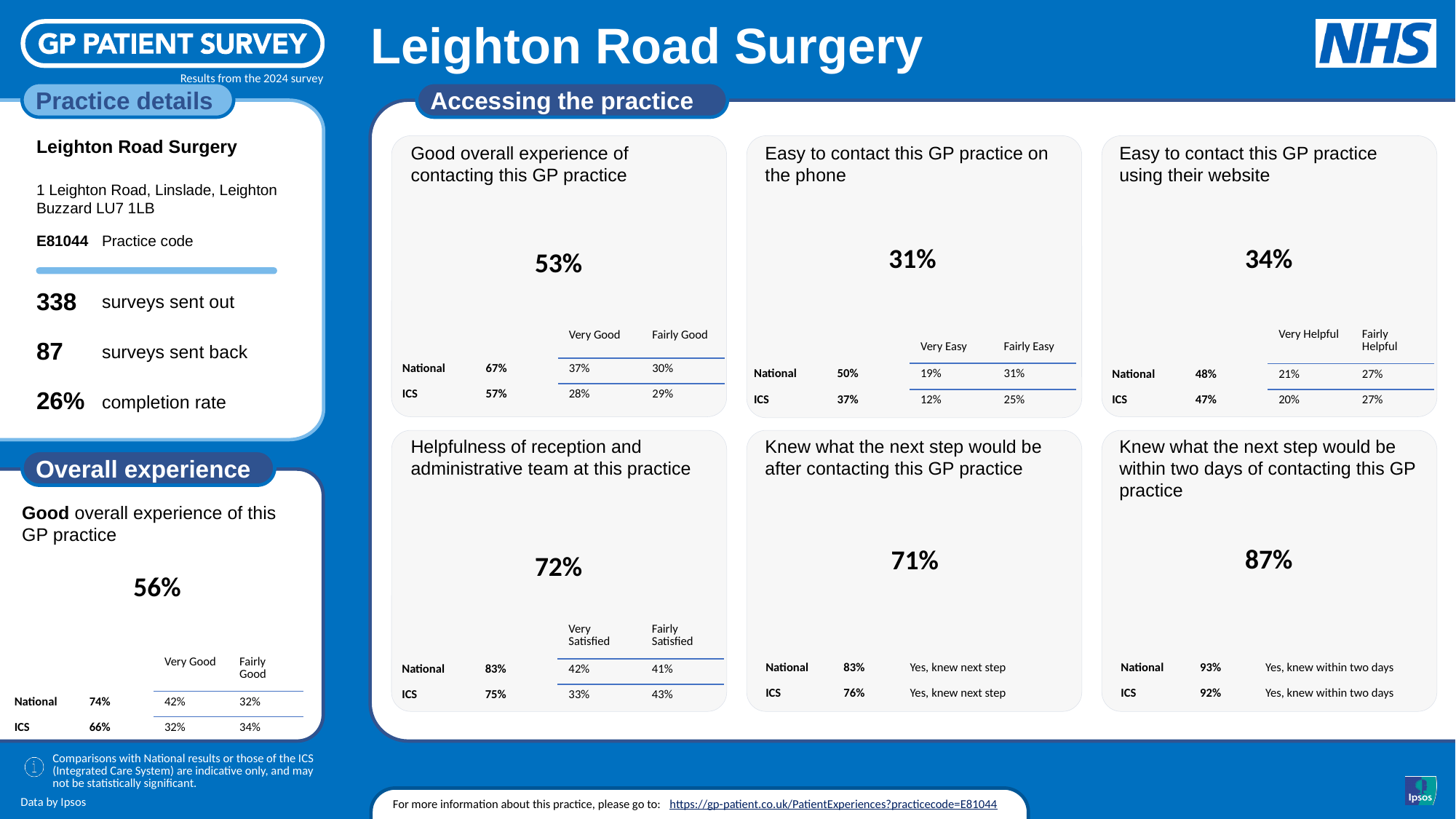
Among the six panels under 'Accessing the practice', which has the highest practice headline percentage? Knew what the next step would be within two days of contacting this GP practice In the 'Helpfulness of reception and administrative team at this practice' panel, what is the ICS value for Very Satisfied? 33% In the 'Easy to contact this GP practice on the phone' panel, what is the difference between the National value and the ICS value? 13% In the 'Easy to contact this GP practice using their website' panel, what is the National value? 48% In the 'Good overall experience of this GP practice' panel under Overall experience, what is the National value for Fairly Good? 32% In the 'Good overall experience of contacting this GP practice' panel, what is the difference between the National value and the practice's headline percentage? 14% In the 'Knew what the next step would be within two days of contacting this GP practice' panel, what is the practice's headline percentage? 87% How many panels are shown under the 'Accessing the practice' heading? 6 Among the six panels under 'Accessing the practice', which has the lowest practice headline percentage? Easy to contact this GP practice on the phone In the 'Knew what the next step would be after contacting this GP practice' panel, which is larger, the National value or the ICS value? National In the 'Easy to contact this GP practice on the phone' panel, what is the practice's headline percentage? 31% In the 'Good overall experience of contacting this GP practice' panel, what is the practice's headline percentage? 53%